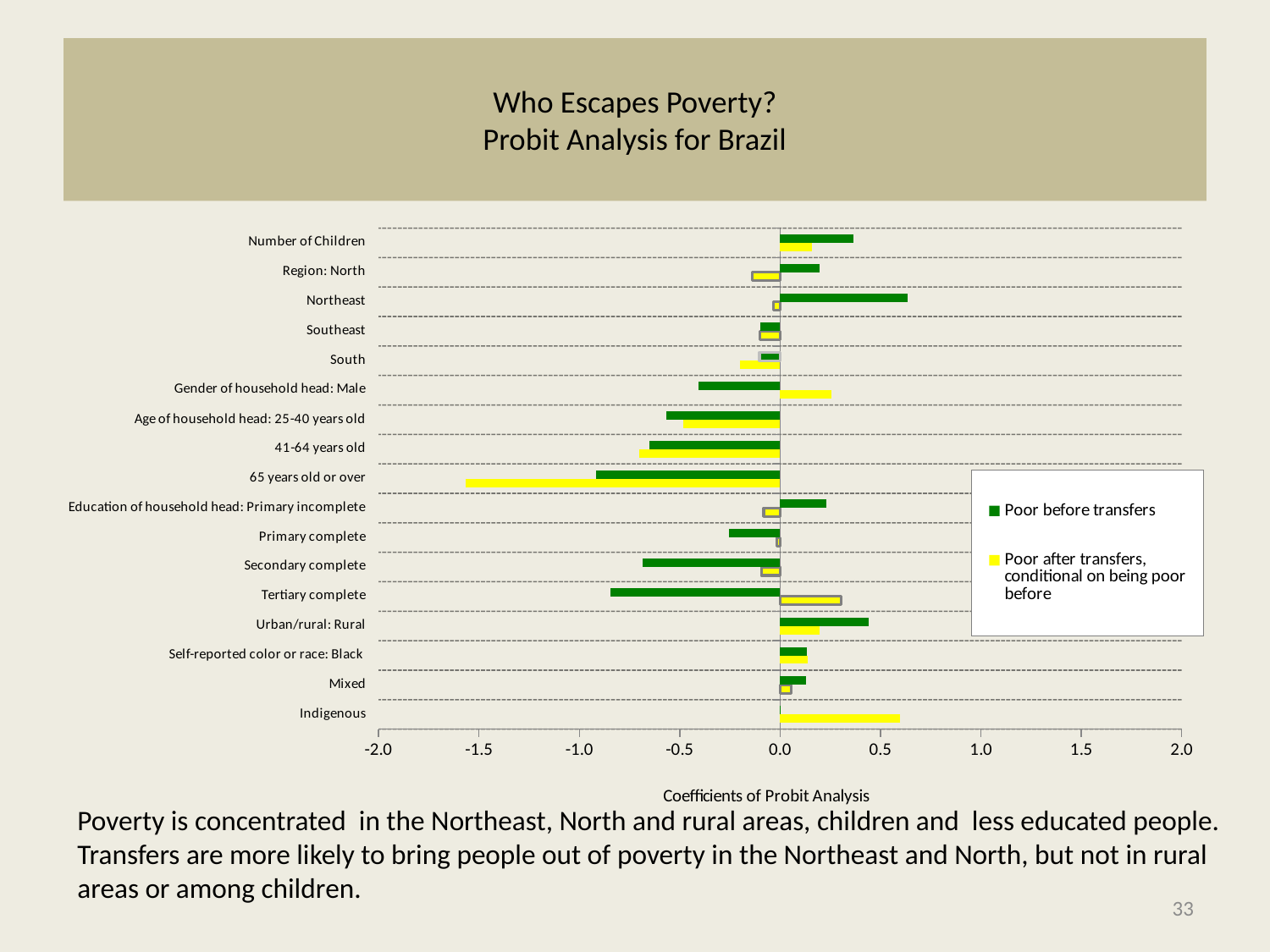
Which category has the lowest value for the 'Poor after transfers, conditional on being poor before' series? 65 years old or over How many series does the legend list? 2 Which is larger for the 'Poor after transfers, conditional on being poor before' series: Indigenous or Mixed? Indigenous How many categories are plotted on the chart? 17 What kind of chart is shown on the slide? Bar chart Which category has the highest value for the 'Poor after transfers, conditional on being poor before' series? Indigenous Is the 'Poor before transfers' value for Tertiary complete greater or less than -0.5? less Which is larger for the 'Poor before transfers' series: Northeast or Region: North? Northeast Which category has the highest value for the 'Poor before transfers' series? Northeast What is the label shown below the x axis of the chart? Coefficients of Probit Analysis Is the 'Poor after transfers, conditional on being poor before' value for 65 years old or over greater or less than -1.0? less Is the 'Poor before transfers' value for Northeast greater or less than 0.5? greater